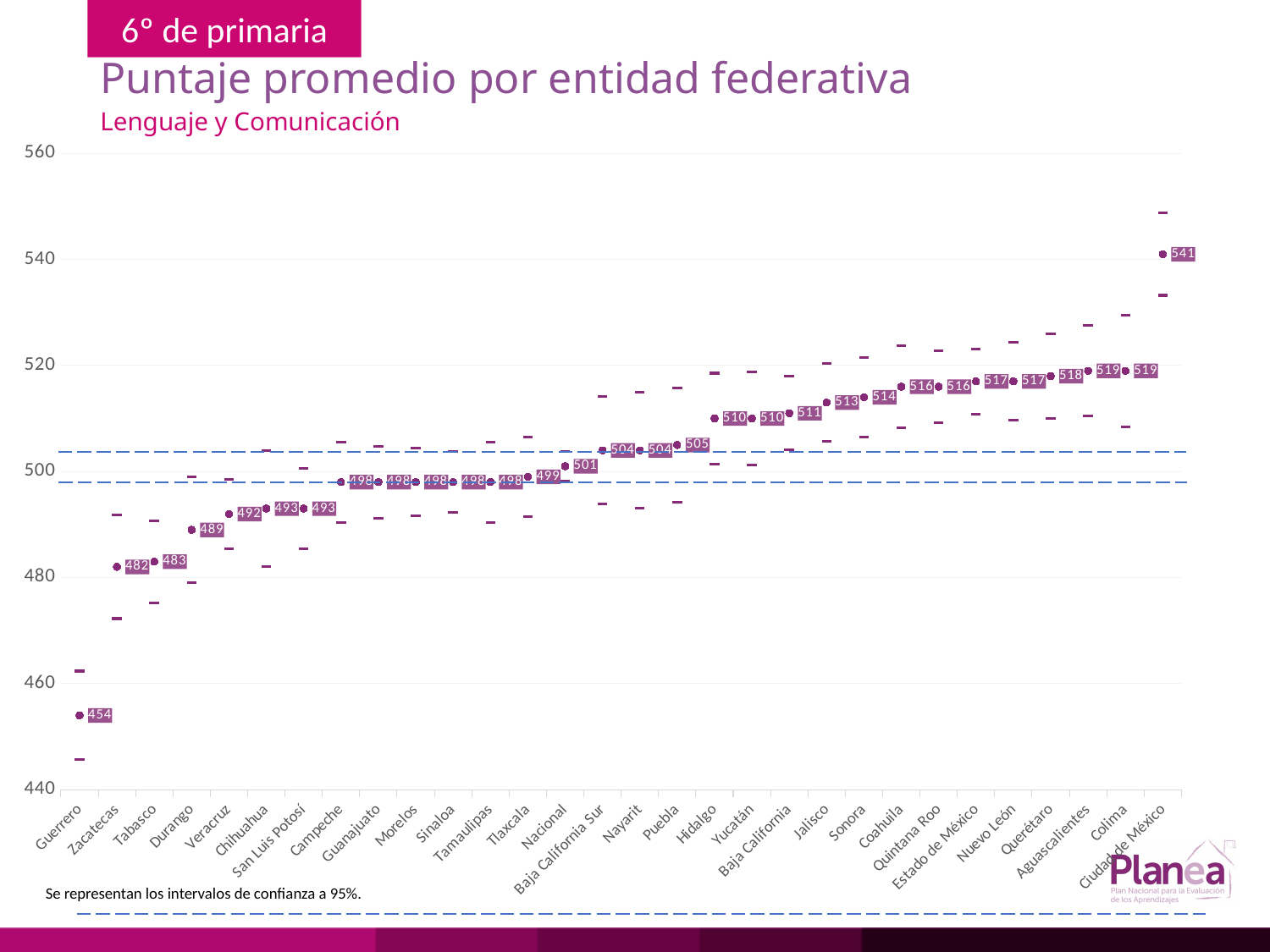
What is the value plotted for Nacional? 501 What is the difference between the scores of Ciudad de México and Guerrero? 87 What is the average score shown for Guerrero? 454 Which entity has the highest average score? Ciudad de México According to the note at the bottom, what confidence level do the intervals represent? 95% Which entity has the lowest average score? Guerrero How many entities (including Nacional) are plotted on the x axis? 30 Which has a higher score, Hidalgo or Durango? Hidalgo What is the average score shown for Ciudad de México? 541 What subject is named in the chart's subtitle? Lenguaje y Comunicación Do the plotted values rise or fall from left to right along the x axis? rise What is the average score shown for Jalisco? 513